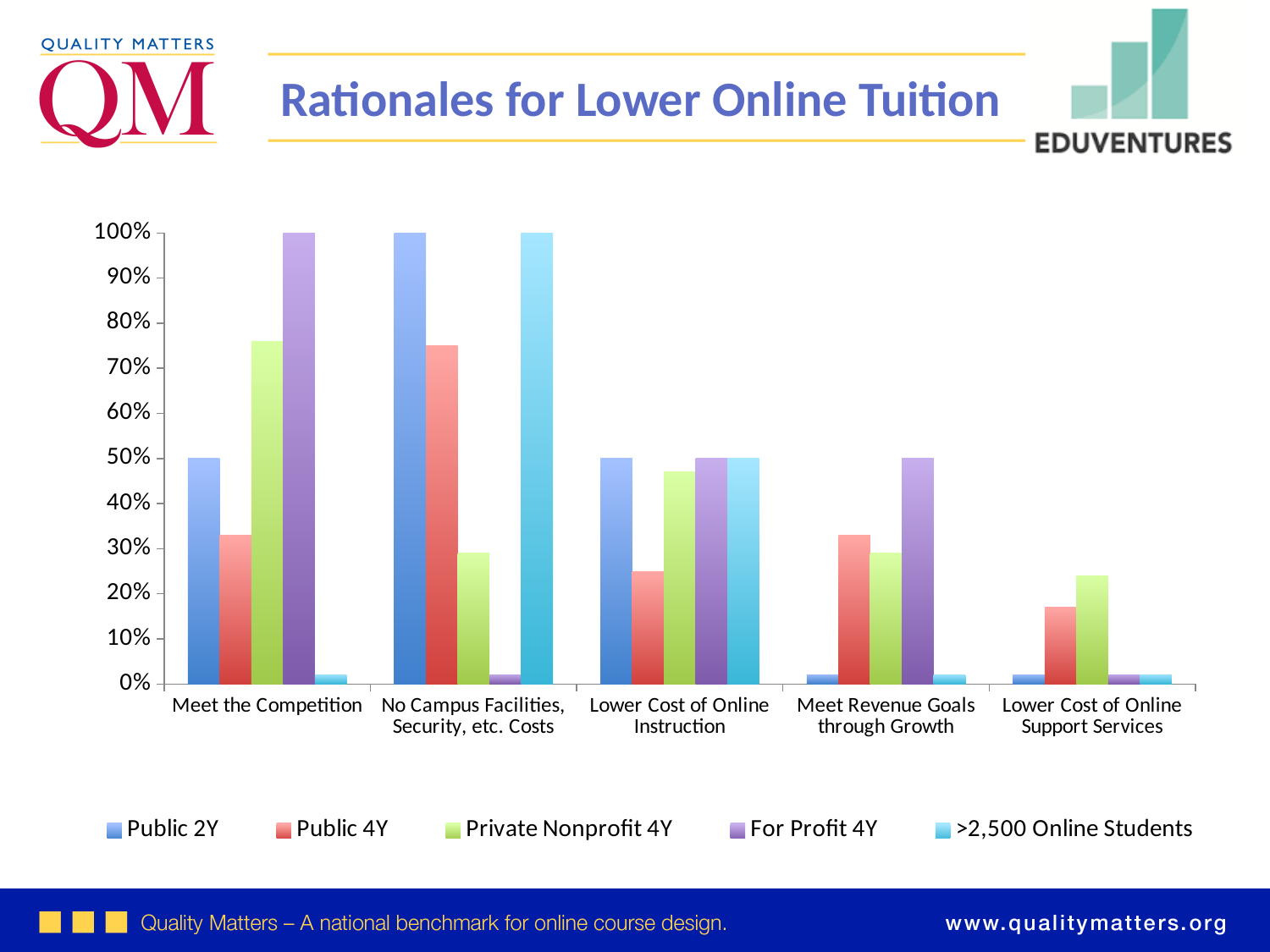
In the Meet the Competition category, which is larger: the value for Public 4Y or the value for Private Nonprofit 4Y? Private Nonprofit 4Y Which series has the highest value in the Meet Revenue Goals through Growth category? For Profit 4Y What is the value for For Profit 4Y in the Meet the Competition category? 100% How many rationale categories are shown on the x axis? 5 What type of chart is shown on the slide? bar chart How many series does the legend list? 5 Is the value for Private Nonprofit 4Y in the Lower Cost of Online Support Services category greater or less than 30%? less What is the value for Public 2Y in the No Campus Facilities, Security, etc. Costs category? 100% What is the title of the chart? Rationales for Lower Online Tuition Is the value for Public 4Y in the No Campus Facilities, Security, etc. Costs category greater or less than 70%? greater What is the value for Public 2Y in the Meet the Competition category? 50% What is the value for For Profit 4Y in the Meet Revenue Goals through Growth category? 50%